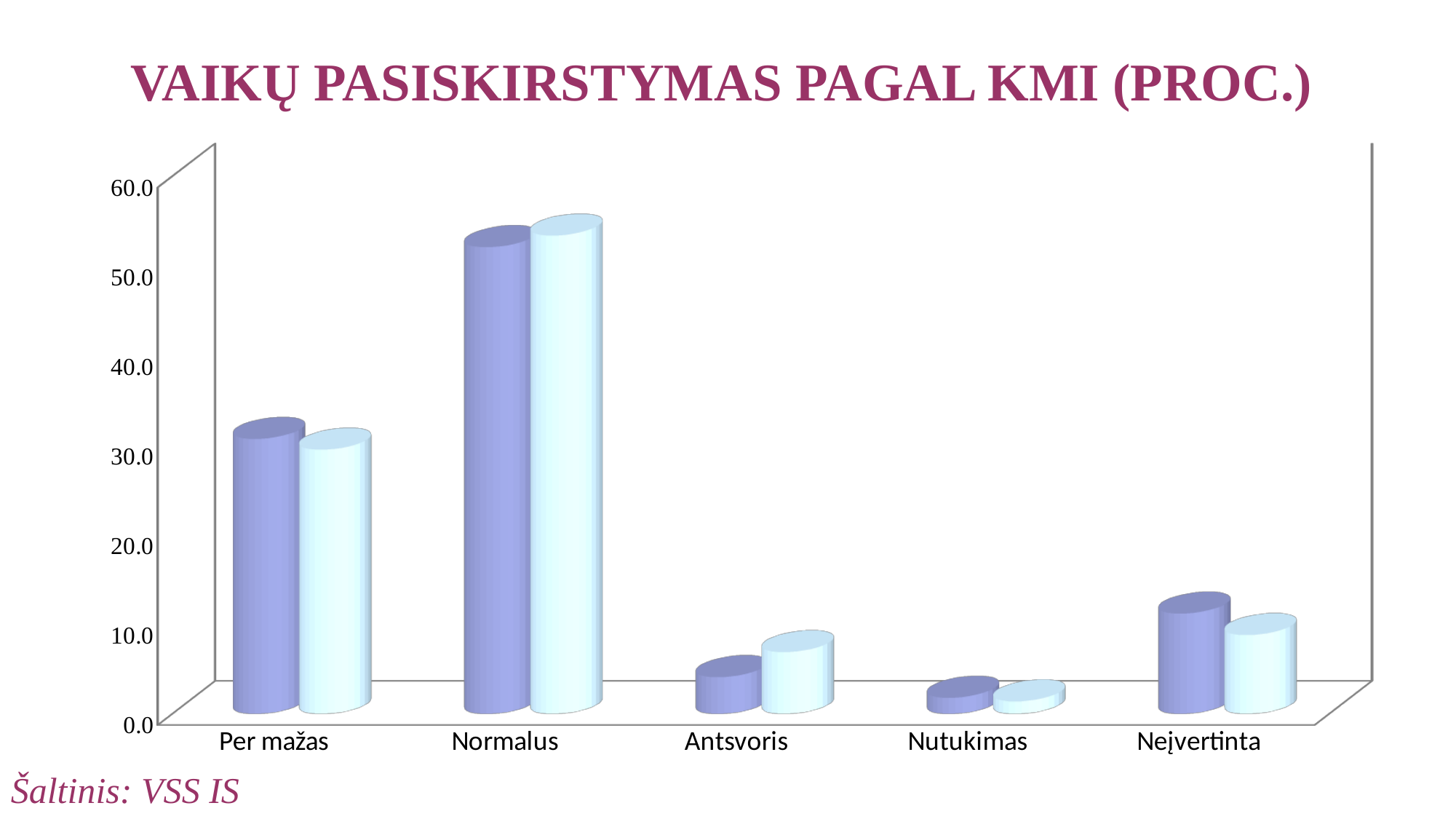
Which category has a larger value: Normalus or Per mažas? Normalus Is the value of the purple bar for Normalus greater or less than 50? greater What is the title of the chart? VAIKŲ PASISKIRSTYMAS PAGAL KMI (PROC.) Is the value of the purple bar for Per mažas greater or less than 20? greater Is the value of the purple bar for Antsvoris greater or less than 10? less What source is cited below the chart? VSS IS Which category has the highest bars? Normalus Which category has the lowest bars? Nutukimas What kind of chart is shown on the slide? bar chart Which category has a larger value: Neįvertinta or Nutukimas? Neįvertinta How many categories are shown on the x axis? 5